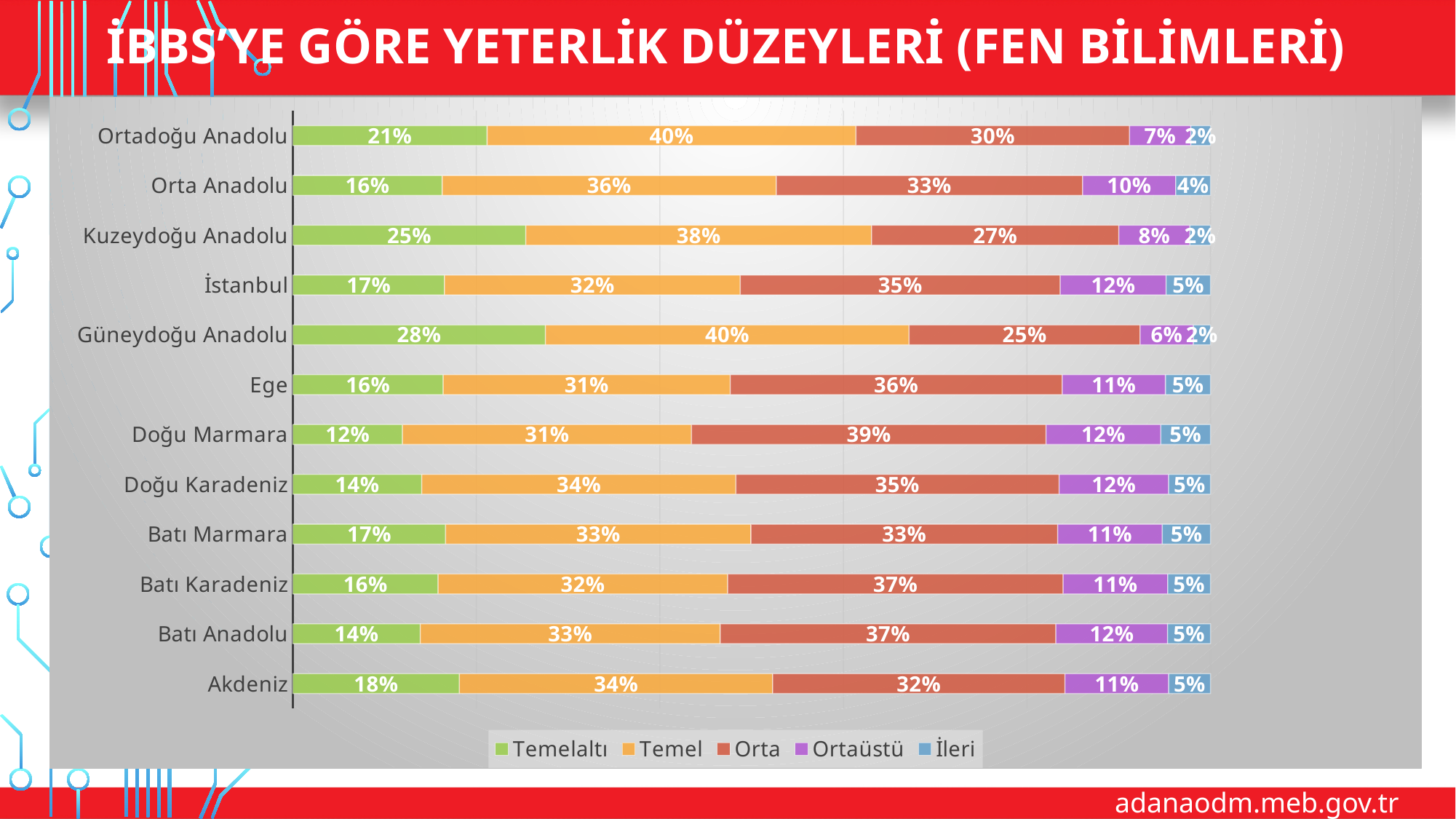
What is the İleri value for Orta Anadolu? 4% How many series does the legend list? 5 Which region has the highest Temelaltı value? Güneydoğu Anadolu What is the Temelaltı value for Güneydoğu Anadolu? 28% What is the total of the stacked bar for Ortadoğu Anadolu? 100% What kind of chart is shown on the slide? Stacked bar chart Which region has the lowest Orta value? Güneydoğu Anadolu Which is larger: the Ortaüstü value for İstanbul or for Kuzeydoğu Anadolu? İstanbul How many regions (categories) are shown in the chart? 12 What is the difference between the Temel values of Ortadoğu Anadolu and İstanbul? 8% What is the Orta value for Doğu Marmara? 39% Which region has the lowest Temelaltı value? Doğu Marmara